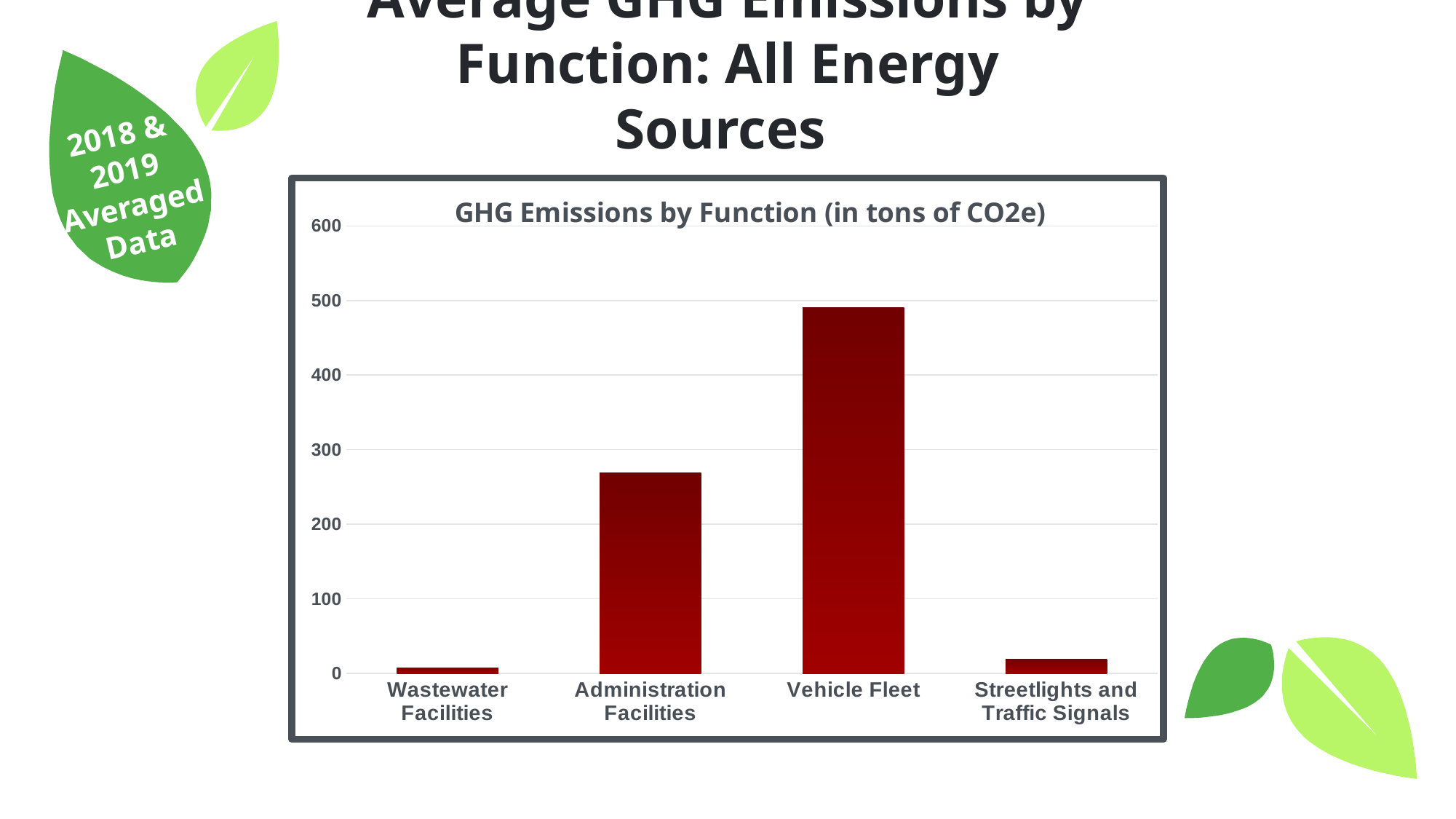
Which function has the highest GHG emissions in the chart? Vehicle Fleet What is the title printed inside the chart area? GHG Emissions by Function (in tons of CO2e) Is the value for Streetlights and Traffic Signals greater or less than 100? less Is the value for Administration Facilities greater or less than 200? greater How many categories are shown on the x axis of the chart? 4 Which has higher GHG emissions, Wastewater Facilities or Streetlights and Traffic Signals? Streetlights and Traffic Signals Which function has the lowest GHG emissions in the chart? Wastewater Facilities What kind of chart is shown on the slide? bar chart Is the value for Administration Facilities greater or less than 300? less Which has higher GHG emissions, Administration Facilities or Vehicle Fleet? Vehicle Fleet What is the highest value shown on the chart's vertical axis? 600